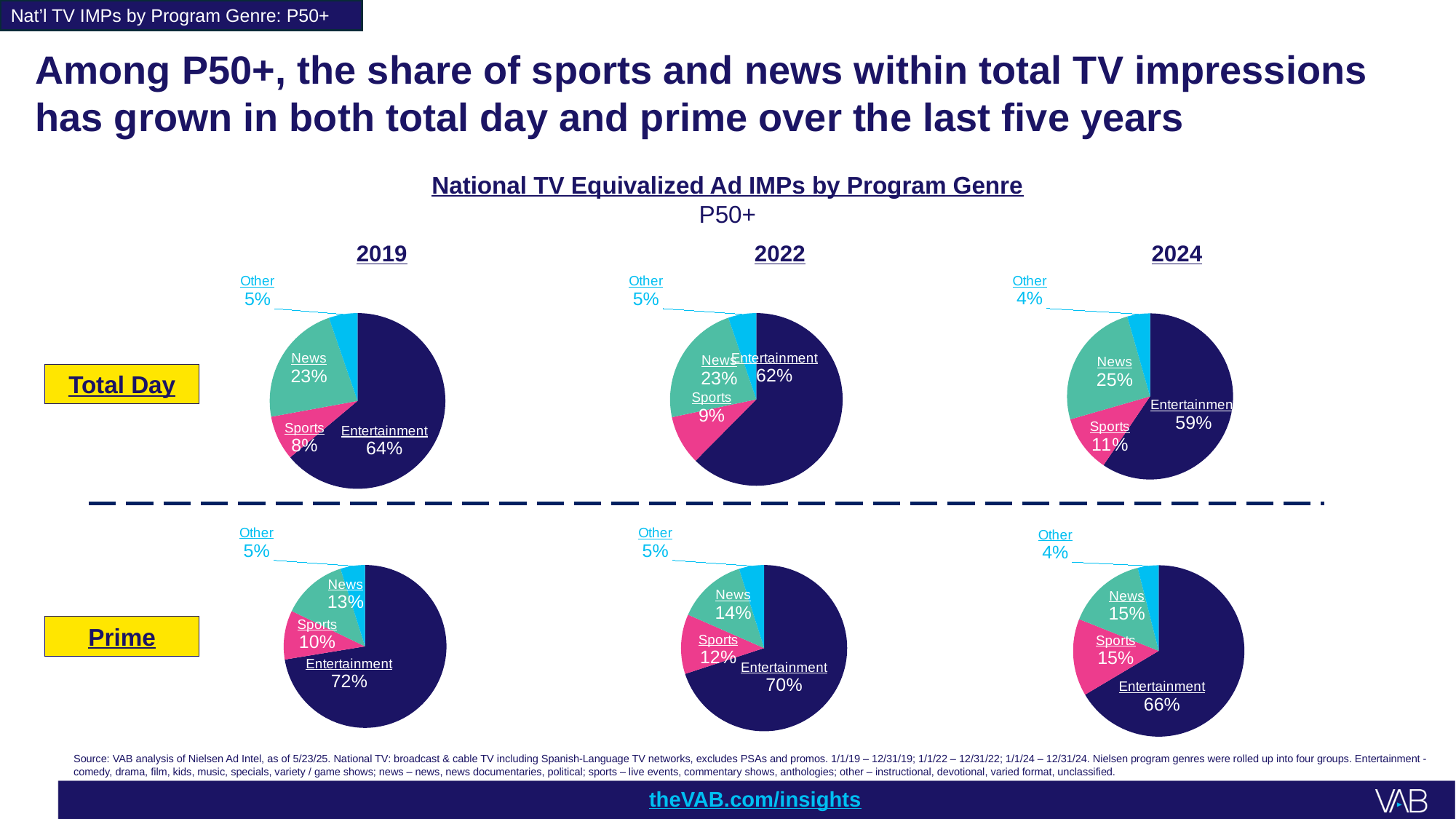
What is the difference in percentage points between the Entertainment share in the Prime 2019 pie chart and the Prime 2024 pie chart? 6 percentage points Across the Prime pie charts from 2019 to 2024, does the Sports share rise or fall? Rise In the Total Day 2022 pie chart, which genre has the smallest share? Other In the Total Day 2024 pie chart, which is larger, the News share or the Sports share? News In the Total Day 2024 pie chart, what share of impressions is Sports? 11% In the Prime 2022 pie chart, what share of impressions is News? 14% What type of chart is used to show the program genre shares on this slide? Pie chart How many pie charts are shown on the slide in total? 6 In the Prime 2019 pie chart, which genre has the largest share? Entertainment In the Prime 2024 pie chart, what share of impressions is Other? 4% In the Total Day 2019 pie chart, what share of impressions is Entertainment? 64% How many genre slices does each pie chart on the slide contain? 4